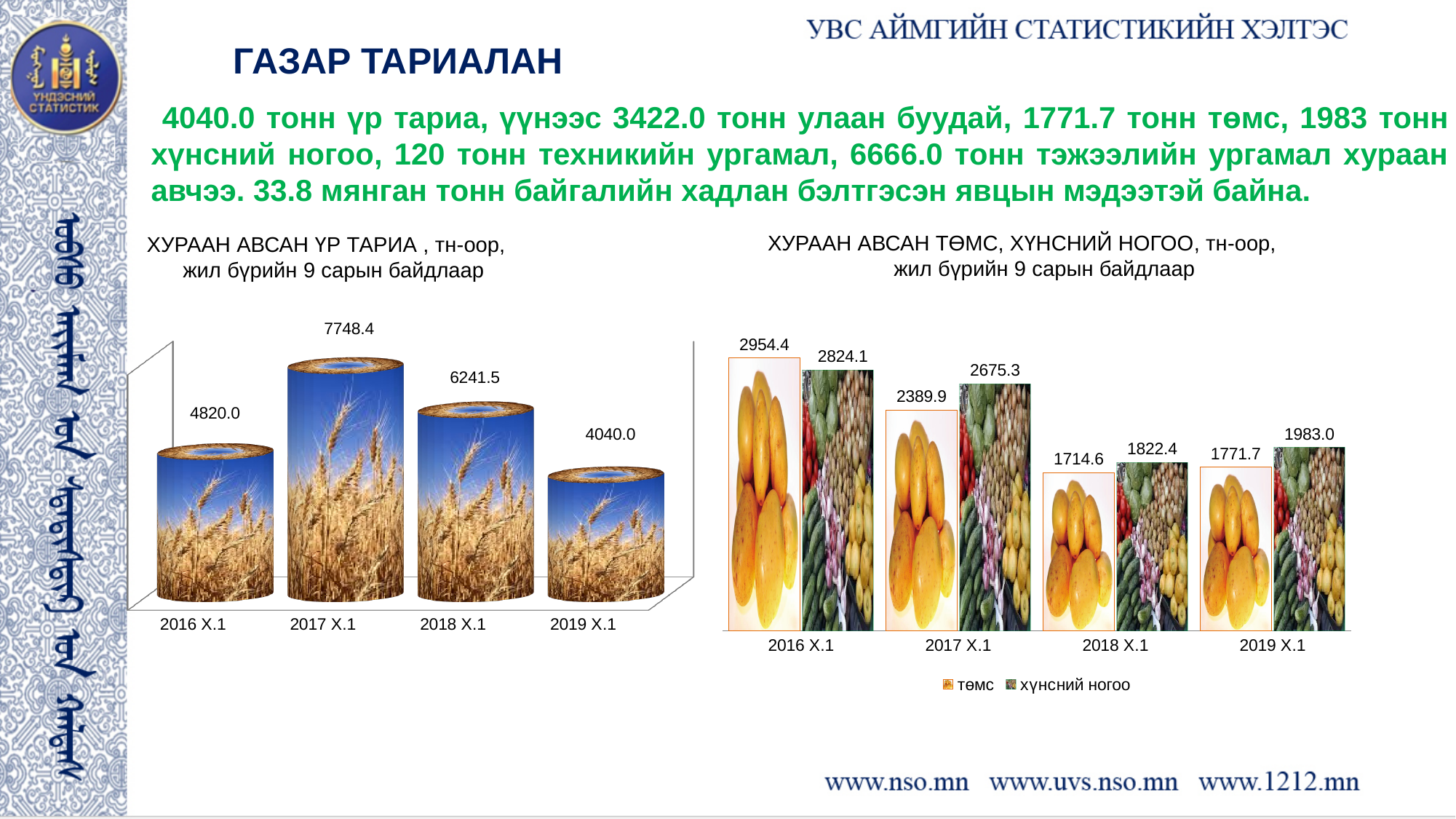
In the left chart (ХУРААН АВСАН ҮР ТАРИА), what is the value for 2017 X.1? 7748.4 In the left chart (ХУРААН АВСАН ҮР ТАРИА), which year has the highest value? 2017 X.1 In the left chart (ХУРААН АВСАН ҮР ТАРИА), do the values rise or fall from 2017 X.1 to 2019 X.1? fall In the left chart (ХУРААН АВСАН ҮР ТАРИА), which year has the lowest value? 2019 X.1 In the right chart (ХУРААН АВСАН ТӨМС, ХҮНСНИЙ НОГОО), what is the difference between хүнсний ногоо and төмс in 2018 X.1? 107.8 In the right chart (ХУРААН АВСАН ТӨМС, ХҮНСНИЙ НОГОО), how many series does the legend list? 2 In the left chart (ХУРААН АВСАН ҮР ТАРИА), what is the difference between the 2017 X.1 and 2018 X.1 values? 1506.9 In the left chart (ХУРААН АВСАН ҮР ТАРИА), how many years are shown? 4 What kind of chart is the left chart (ХУРААН АВСАН ҮР ТАРИА)? bar chart In the right chart (ХУРААН АВСАН ТӨМС, ХҮНСНИЙ НОГОО), what is the value for төмс in 2016 X.1? 2954.4 In the right chart (ХУРААН АВСАН ТӨМС, ХҮНСНИЙ НОГОО), which is larger in 2017 X.1: төмс or хүнсний ногоо? хүнсний ногоо In the right chart (ХУРААН АВСАН ТӨМС, ХҮНСНИЙ НОГОО), what is the value for хүнсний ногоо in 2019 X.1? 1983.0